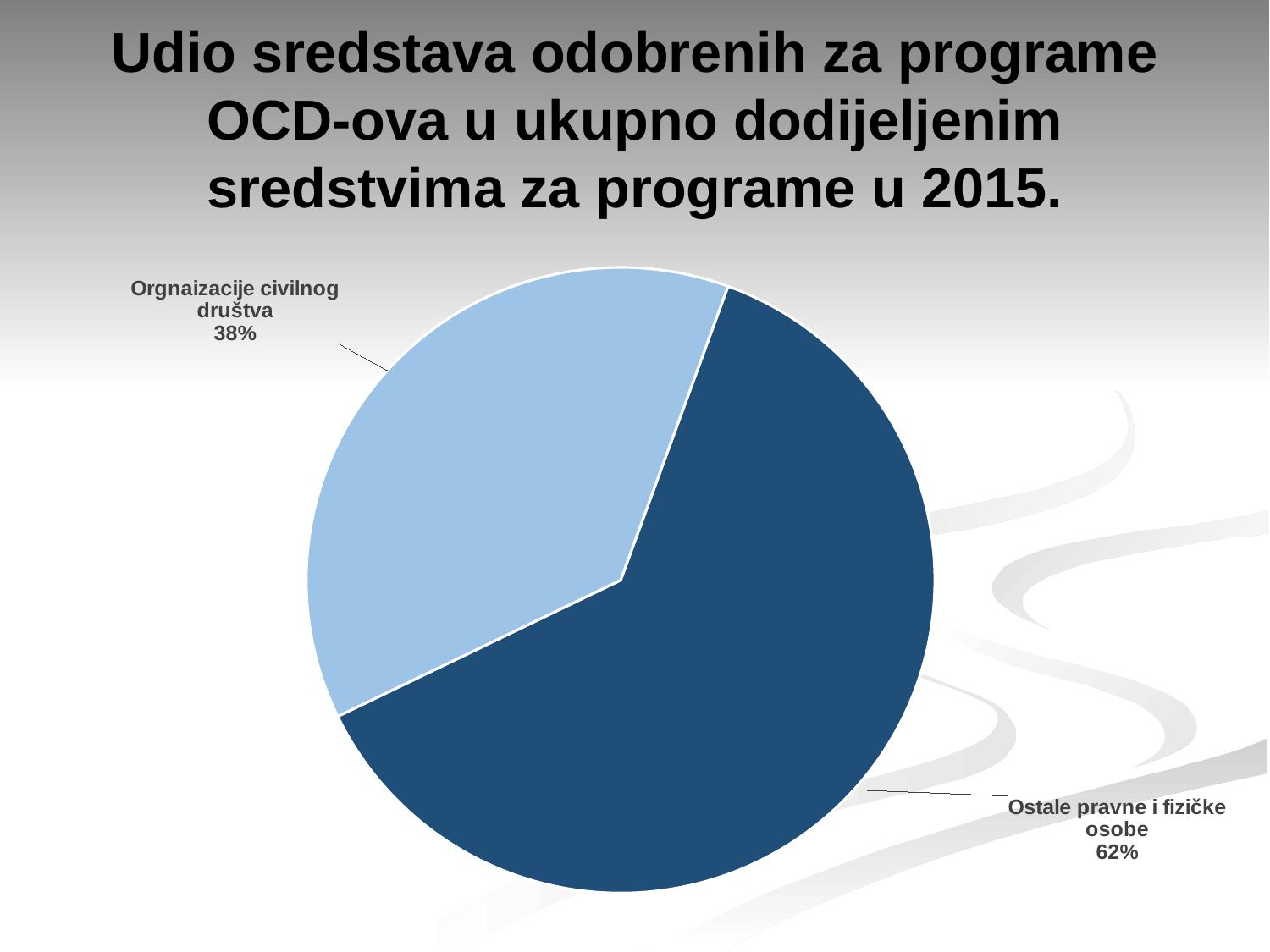
What is the difference in percentage points between "Ostale pravne i fizičke osobe" and "Orgnaizacije civilnog društva"? 24 percentage points What kind of chart is shown on the slide? pie chart Which slice is the smallest? Orgnaizacije civilnog društva What share of the pie does "Orgnaizacije civilnog društva" hold? 38% Is the share for "Ostale pravne i fizičke osobe" greater or less than 50%? greater Which slice is the largest? Ostale pravne i fizičke osobe Which slice is shown in the darker blue colour? Ostale pravne i fizičke osobe Which is larger: the share for "Orgnaizacije civilnog društva" or the share for "Ostale pravne i fizičke osobe"? Ostale pravne i fizičke osobe What share of the pie does "Ostale pravne i fizičke osobe" hold? 62% Is the share for "Orgnaizacije civilnog društva" greater or less than 50%? less Which year does the chart title refer to? 2015 How many slices does the pie chart have? 2